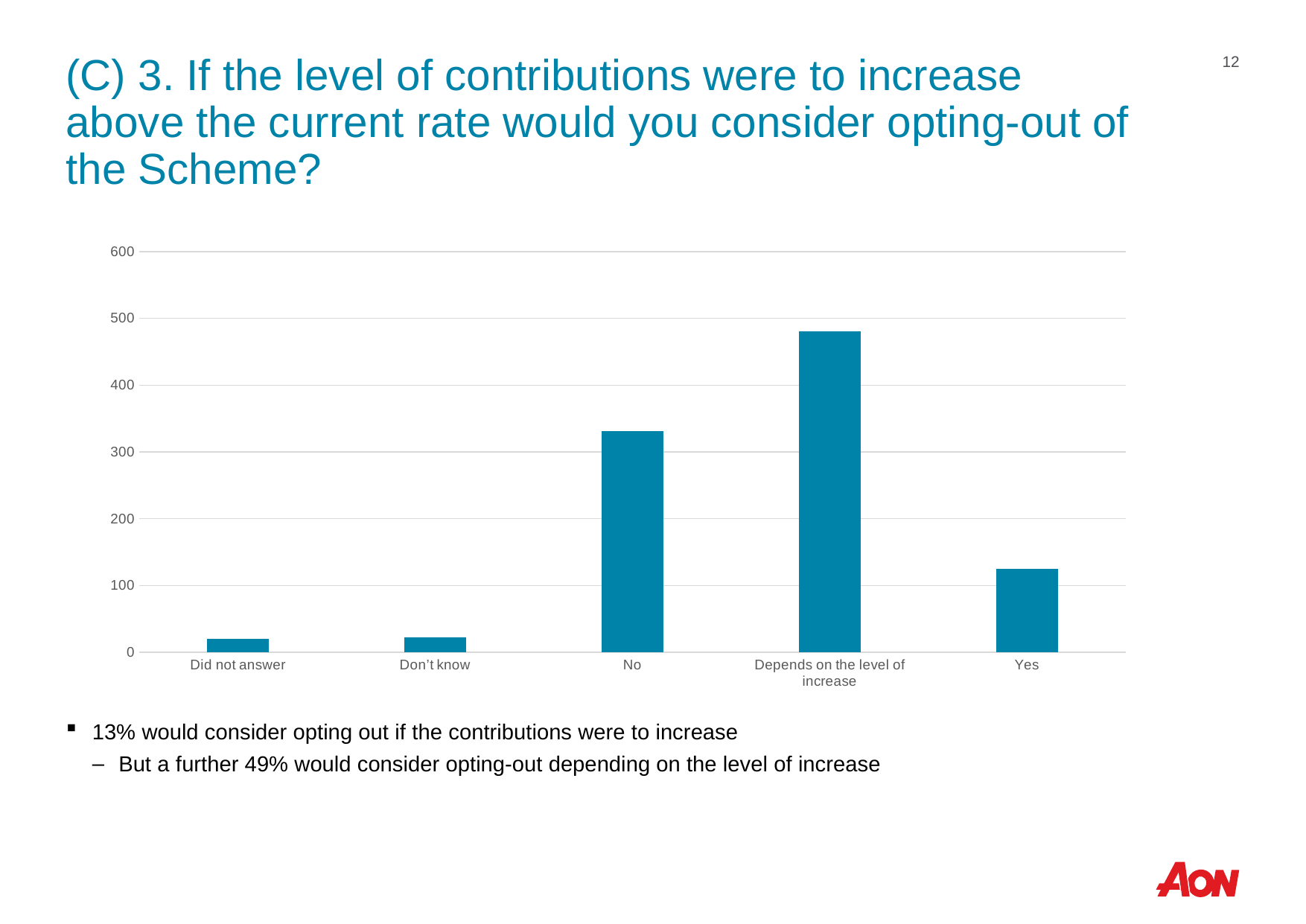
Which is larger, the value for No or the value for Yes? No Which is larger, the value for Depends on the level of increase or the value for No? Depends on the level of increase What kind of chart is shown on the slide? bar chart Is the value for Depends on the level of increase greater or less than 400? greater Is the value for No greater or less than 400? less What is the highest value shown on the y axis of the chart? 600 Which category has the highest value in the chart? Depends on the level of increase Is the value for No greater or less than 300? greater How many categories are shown on the x axis of the chart? 5